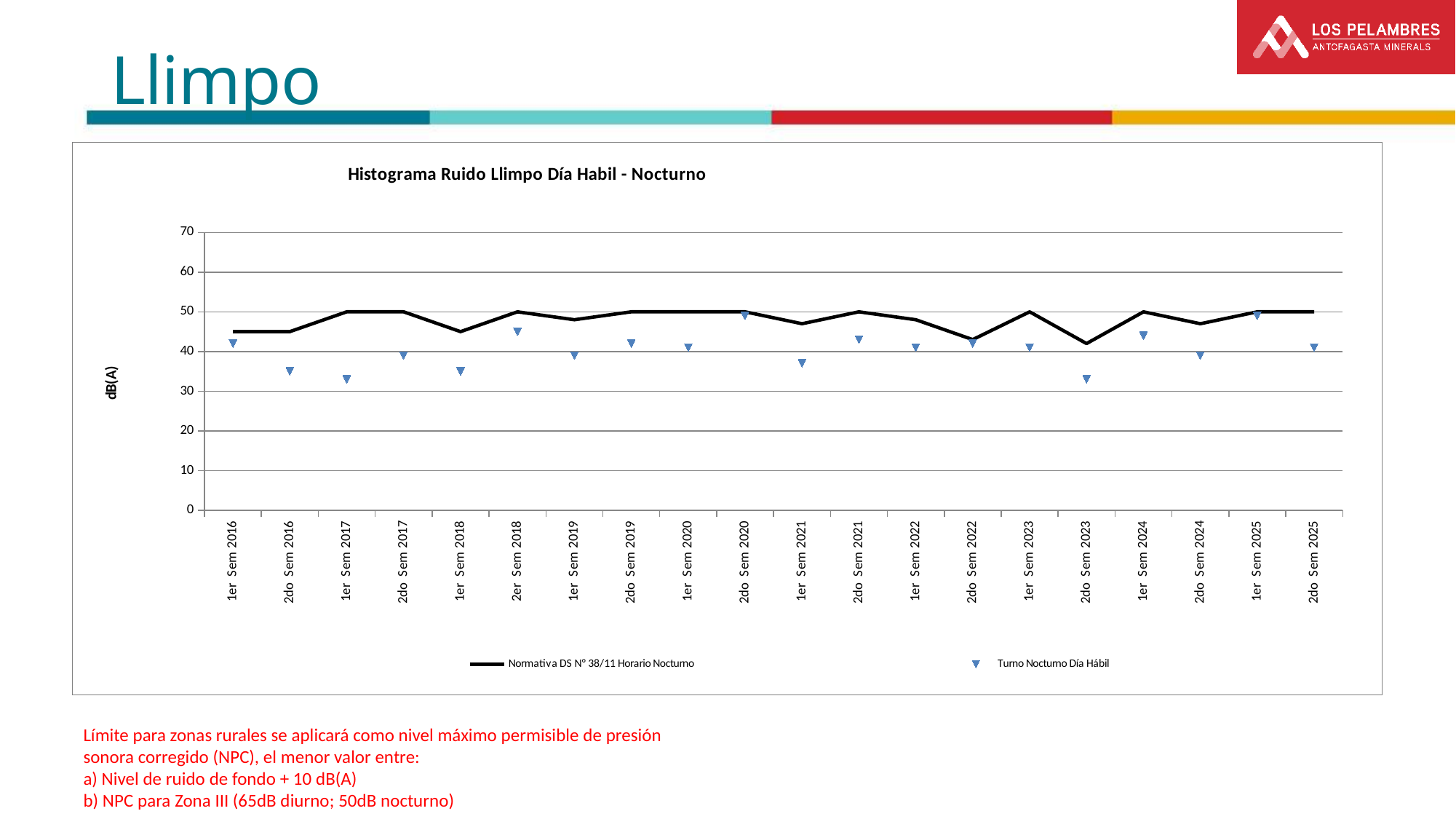
What is the value of the Normativa DS N° 38/11 Horario Nocturno line at 1er Sem 2017? 50 What is the title of the chart? Histograma Ruido Llimpo Día Habil - Nocturno What is the label of the y axis? dB(A) What is the value of the Normativa DS N° 38/11 Horario Nocturno line at 2do Sem 2025? 50 How many series does the chart legend list? 2 Is the Turno Nocturno Día Hábil value for 1er Sem 2016 greater or less than 40? greater At 2do Sem 2016, which is larger: the Normativa DS N° 38/11 Horario Nocturno value or the Turno Nocturno Día Hábil value? Normativa DS N° 38/11 Horario Nocturno How many semesters are shown along the x axis of the chart? 20 Is the Turno Nocturno Día Hábil value for 2do Sem 2020 greater or less than 40? greater What kind of chart is shown on the slide? line chart Is the Turno Nocturno Día Hábil value for 2do Sem 2023 greater or less than 40? less